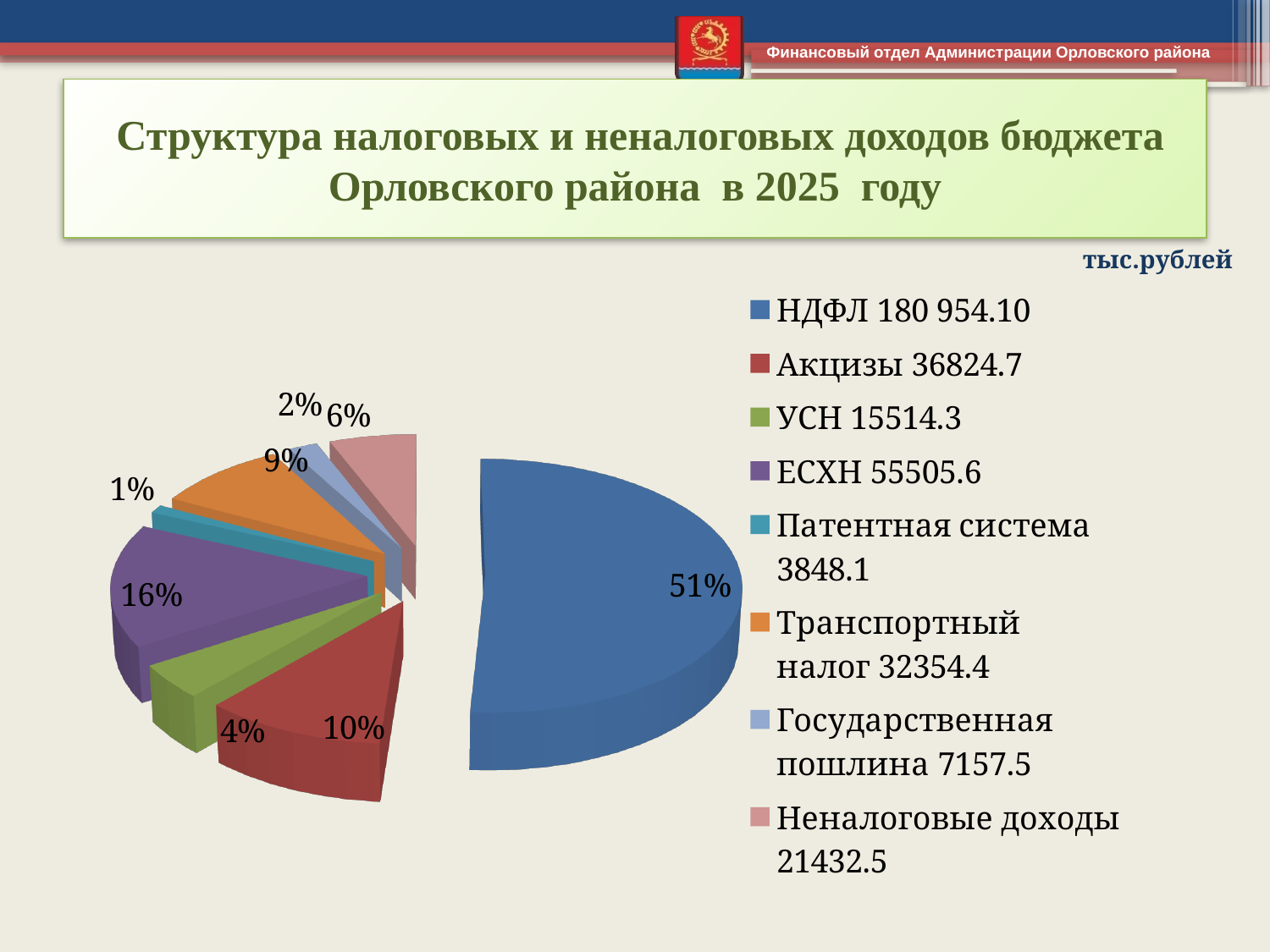
What value is listed in the legend for Акцизы? 36824.7 What percentage share does the ЕСХН slice have? 16% What percentage share does the Акцизы slice have? 10% What value is listed in the legend for Неналоговые доходы? 21432.5 What kind of chart is shown on the slide? pie chart Which slice is larger, ЕСХН or Акцизы? ЕСХН What percentage share does the Патентная система slice have? 1% Which category has the largest slice of the pie? НДФЛ How many slices does the pie chart have? 8 Which category has the smallest slice of the pie? Патентная система